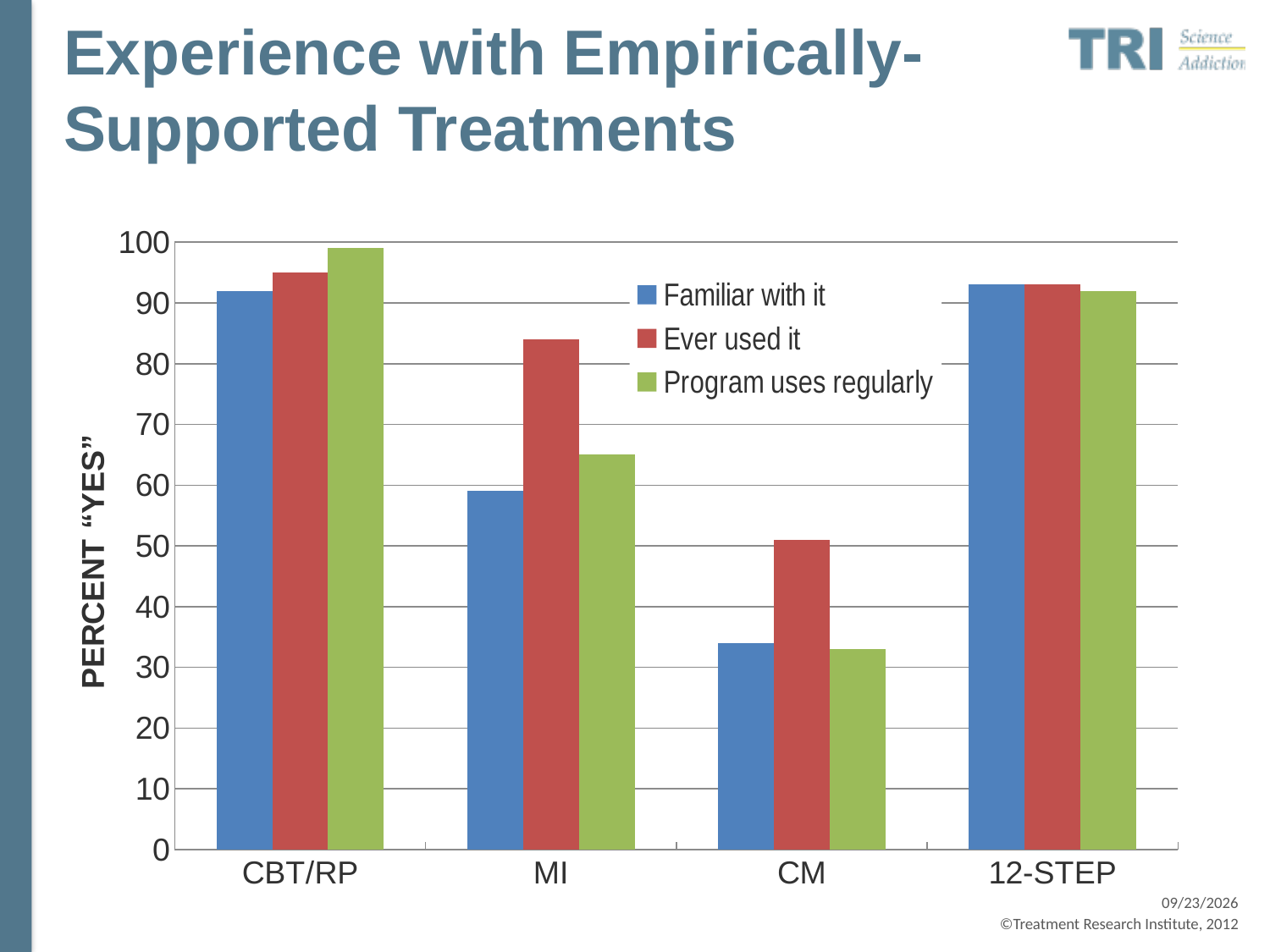
Is the "Ever used it" value for MI greater or less than 80? greater For MI, which is larger: "Familiar with it" or "Ever used it"? Ever used it For CM, which is larger: "Ever used it" or "Program uses regularly"? Ever used it How many treatment categories are shown on the x axis? 4 Which treatment has the highest value for "Program uses regularly"? CBT/RP What is the label on the vertical axis of the chart? PERCENT "YES" Which treatment has the lowest value for "Familiar with it"? CM Is the "Program uses regularly" value for CBT/RP greater or less than 90? greater Which treatment has the lowest value for "Ever used it"? CM Is the "Familiar with it" value for CM greater or less than 40? less What kind of chart is shown on the slide? Bar chart How many series does the legend list? 3